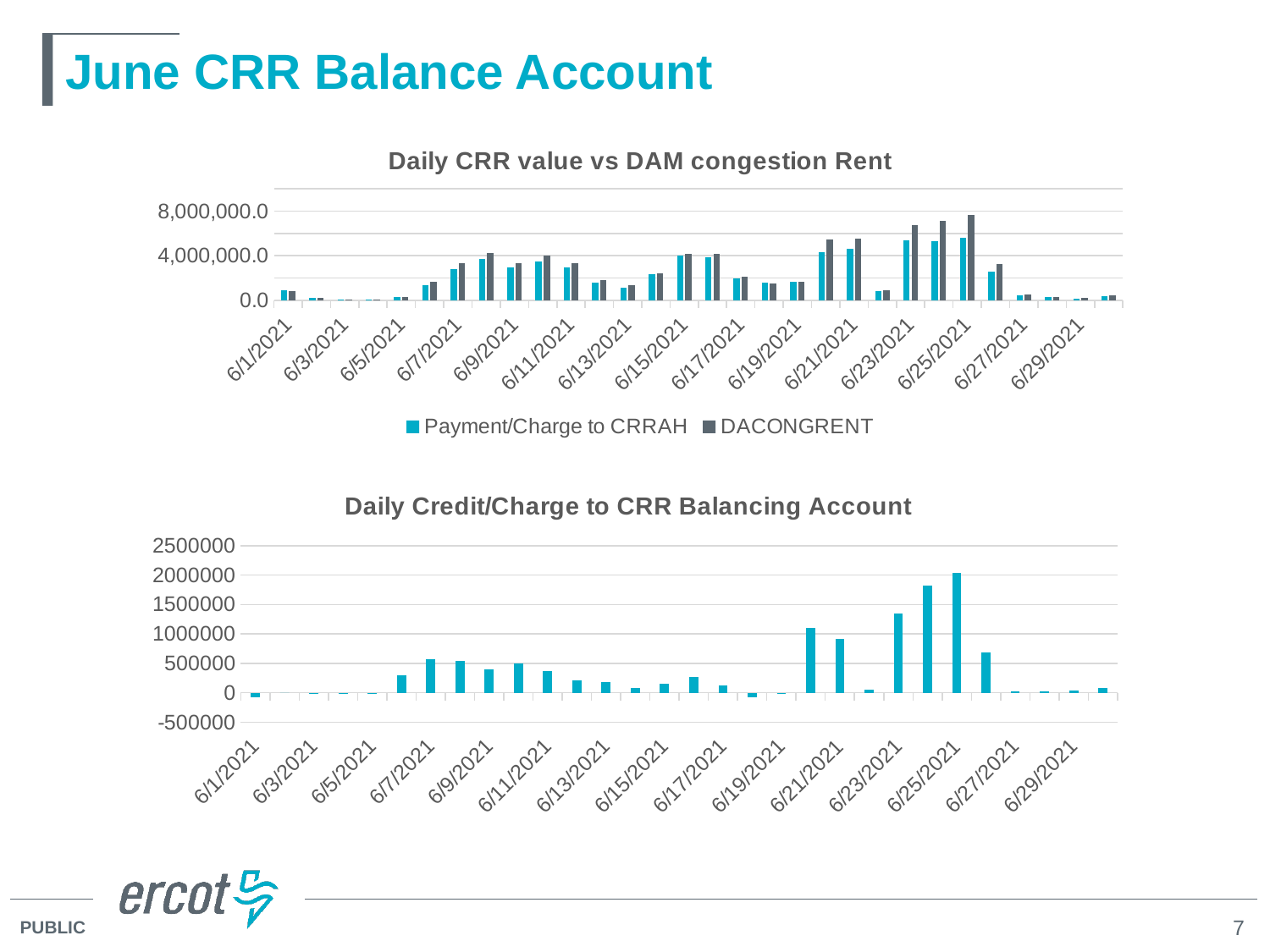
In the top chart "Daily CRR value vs DAM congestion Rent", is the Payment/Charge to CRRAH value for 6/1/2021 greater or less than 4,000,000.0? less How many series does the legend of the top chart "Daily CRR value vs DAM congestion Rent" list? 2 In the bottom chart "Daily Credit/Charge to CRR Balancing Account", on which date is the value highest? 6/25/2021 What is the title of the bottom chart on the slide? Daily Credit/Charge to CRR Balancing Account In the top chart "Daily CRR value vs DAM congestion Rent", what are the two series named in the legend? Payment/Charge to CRRAH and DACONGRENT In the bottom chart "Daily Credit/Charge to CRR Balancing Account", is the value for 6/25/2021 greater or less than 1500000? greater In the top chart "Daily CRR value vs DAM congestion Rent", on 6/25/2021 which series has the larger value, Payment/Charge to CRRAH or DACONGRENT? DACONGRENT What type of chart is the top chart titled "Daily CRR value vs DAM congestion Rent"? bar chart In the top chart "Daily CRR value vs DAM congestion Rent", is the DACONGRENT value for 6/25/2021 greater or less than 4,000,000.0? greater In the top chart "Daily CRR value vs DAM congestion Rent", on which date is the DACONGRENT value highest? 6/25/2021 In the bottom chart "Daily Credit/Charge to CRR Balancing Account", which date has the larger value, 6/21/2021 or 6/25/2021? 6/25/2021